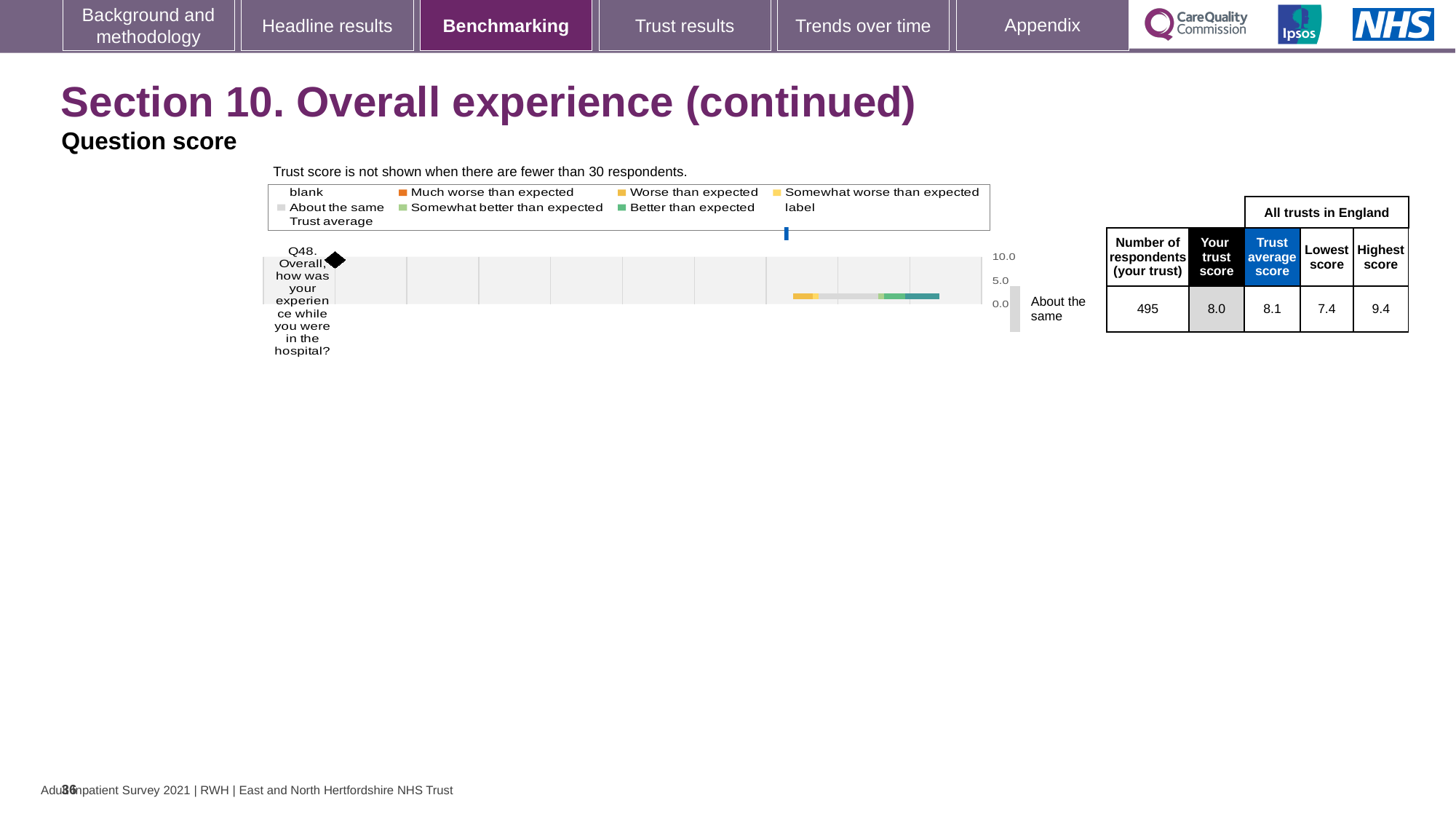
How many respondents from the trust answered Q48? 495 What is the trust score for Q48 shown in the table? 8.0 What is the difference between the highest score and the lowest score for Q48? 2.0 What benchmark category is the trust's Q48 score placed in? About the same How many questions are plotted on the chart? 1 What is the lowest score among all trusts in England for Q48? 7.4 What type of chart is shown on the slide for Q48? bar chart Which is larger for Q48: the trust score or the trust average score? Trust average score What is the trust average score for Q48 across all trusts in England? 8.1 Which question is plotted on the chart? Q48. Overall, how was your experience while you were in the hospital? What is the highest score among all trusts in England for Q48? 9.4 What is the maximum value shown on the chart's score axis? 10.0